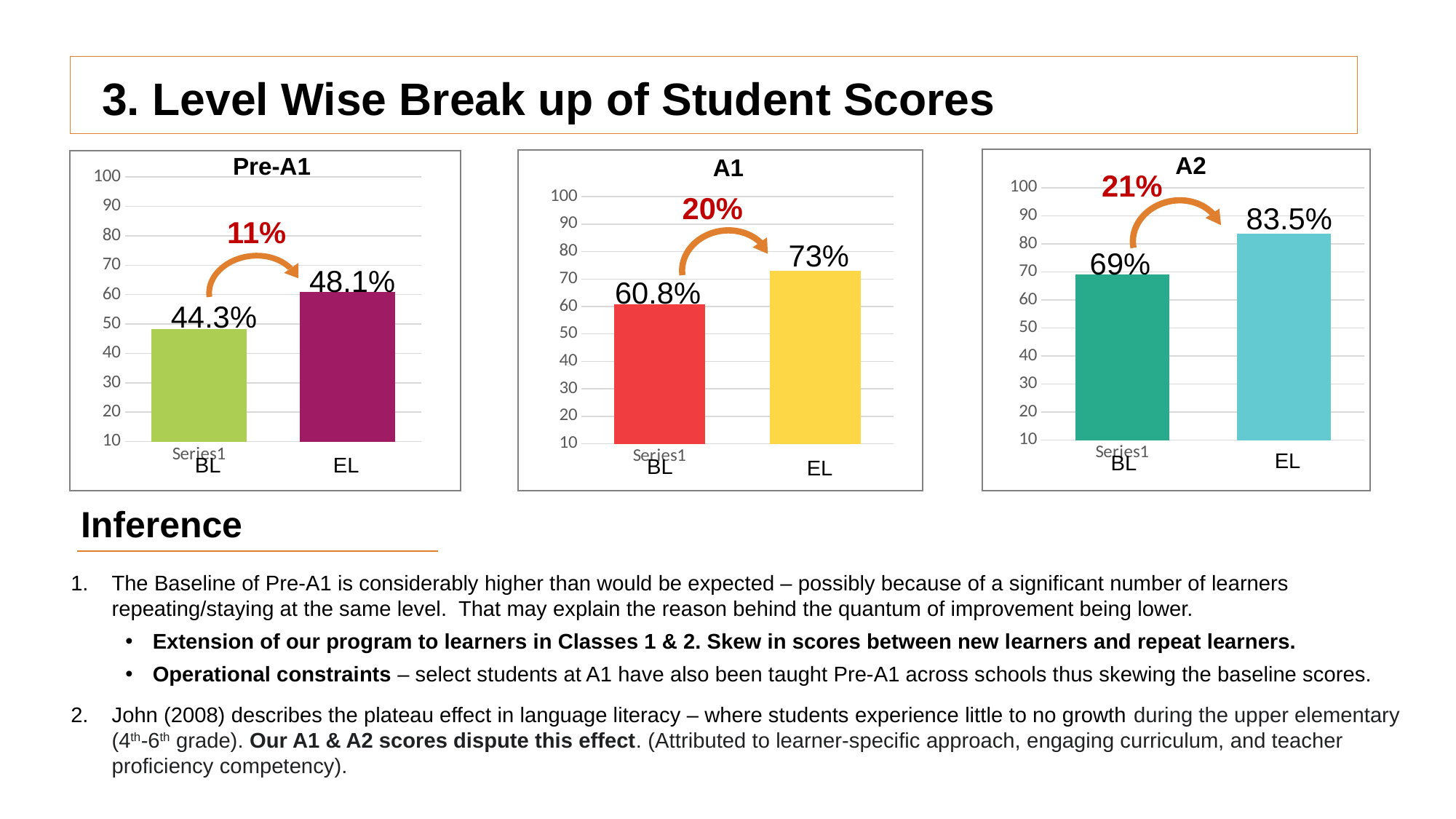
In the Pre-A1 chart, what is the value for BL? 44.3% In the A2 chart, what is the value for BL? 69% In the A1 chart, what is the value for BL? 60.8% How many bars are plotted in the A1 chart? 2 In the A2 chart, which category has the higher value, BL or EL? EL In the A1 chart, what is the value for EL? 73% What type of chart is the A2 chart? Bar chart In the Pre-A1 chart, what is the value for EL? 48.1% What percentage improvement is annotated above the arrow in the A2 chart? 21% In the A1 chart, what is the difference between the EL and BL values? 12.2 percentage points In the A2 chart, what is the value for EL? 83.5%